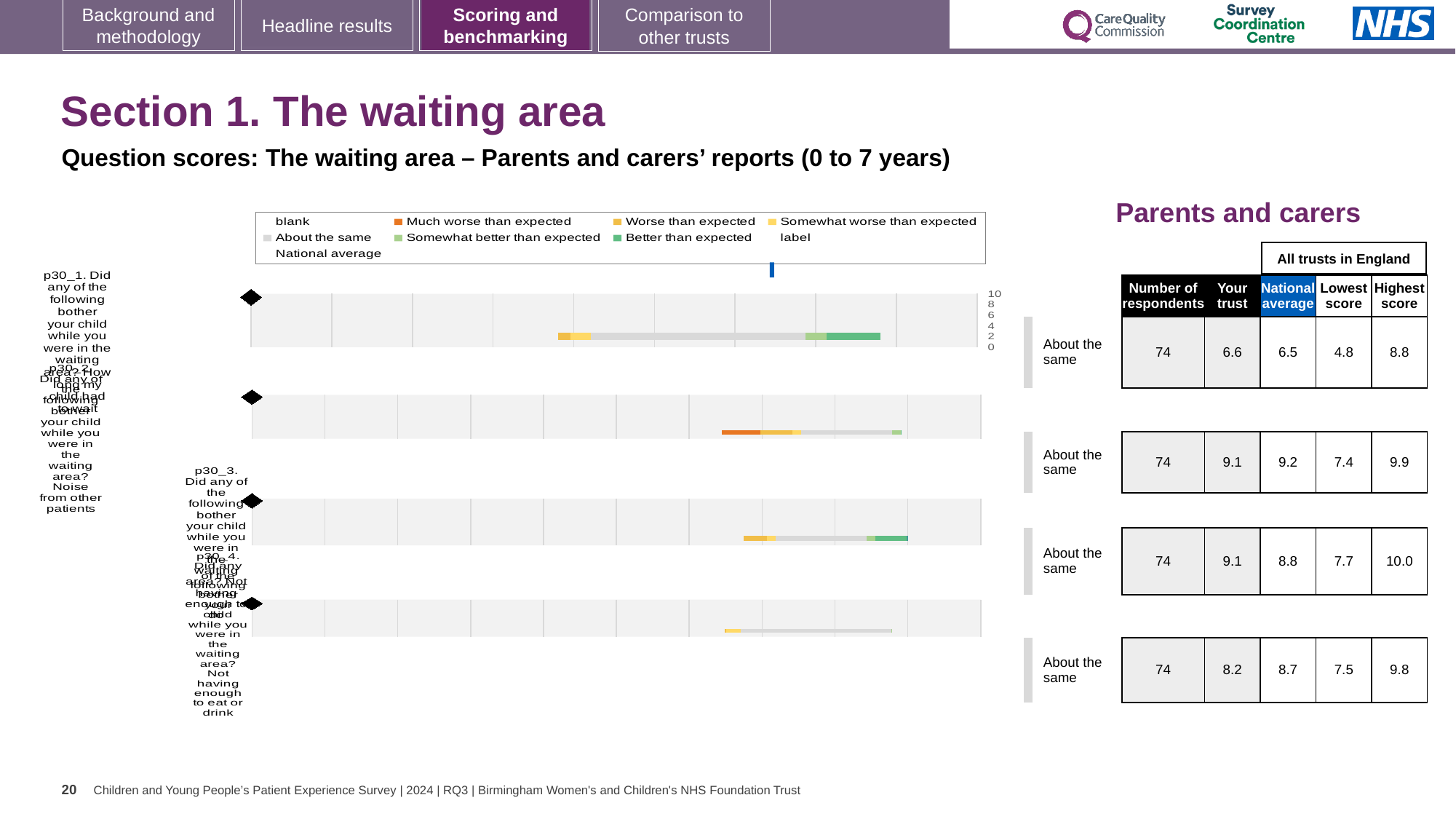
Which question has the lowest 'Your trust' score? p30_1. How long my child had to wait What is the difference between the national average and the 'Your trust' score for p30_4 (Not having enough to eat or drink)? 0.5 What is the highest score among all trusts in England for p30_3 (Not having enough to do)? 10.0 For p30_1 (How long my child had to wait), which is larger: the 'Your trust' score or the national average? Your trust How many respondents answered p30_4 (Not having enough to eat or drink)? 74 What kind of chart is shown on the slide? bar chart How many entries does the chart legend list? 9 What is the lowest score among all trusts in England for p30_1 (How long my child had to wait)? 4.8 What benchmark category is shown for each of the four questions? About the same What is the 'Your trust' score for p30_1 (How long my child had to wait)? 6.6 How many question bars are plotted in the chart? 4 What is the national average score for p30_2 (Noise from other patients)? 9.2